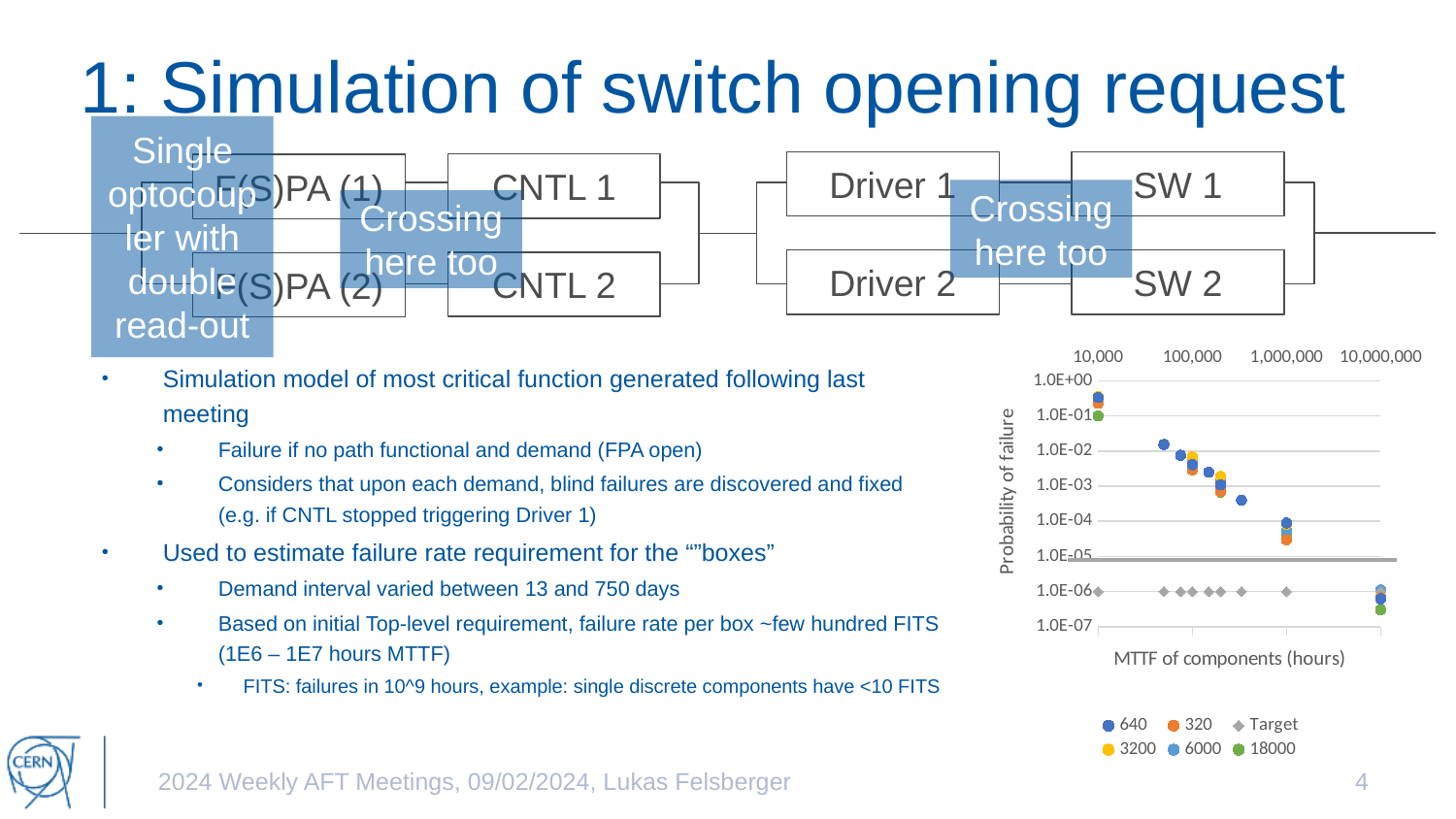
Is the probability of failure for the 640 series at an MTTF of 10,000 hours greater or less than 1.0E-01? greater Is the probability of failure for the Target series greater or less than 1.0E-05? less At an MTTF of 10,000 hours, which series has the higher probability of failure, 640 or 18000? 640 What kind of chart is shown on the slide? scatter chart How many series does the chart legend list? 6 Which series in the chart is plotted with diamond markers? Target Does the Target series rise, fall, or stay flat as the MTTF of components increases? stay flat What is the title of the chart's x axis? MTTF of components (hours) What is the title of the chart's y axis? Probability of failure Is the probability of failure for the 18000 series at an MTTF of 10,000 hours greater or less than 1.0E+00? less Does the probability of failure for the 640 series rise or fall as the MTTF of components increases? fall